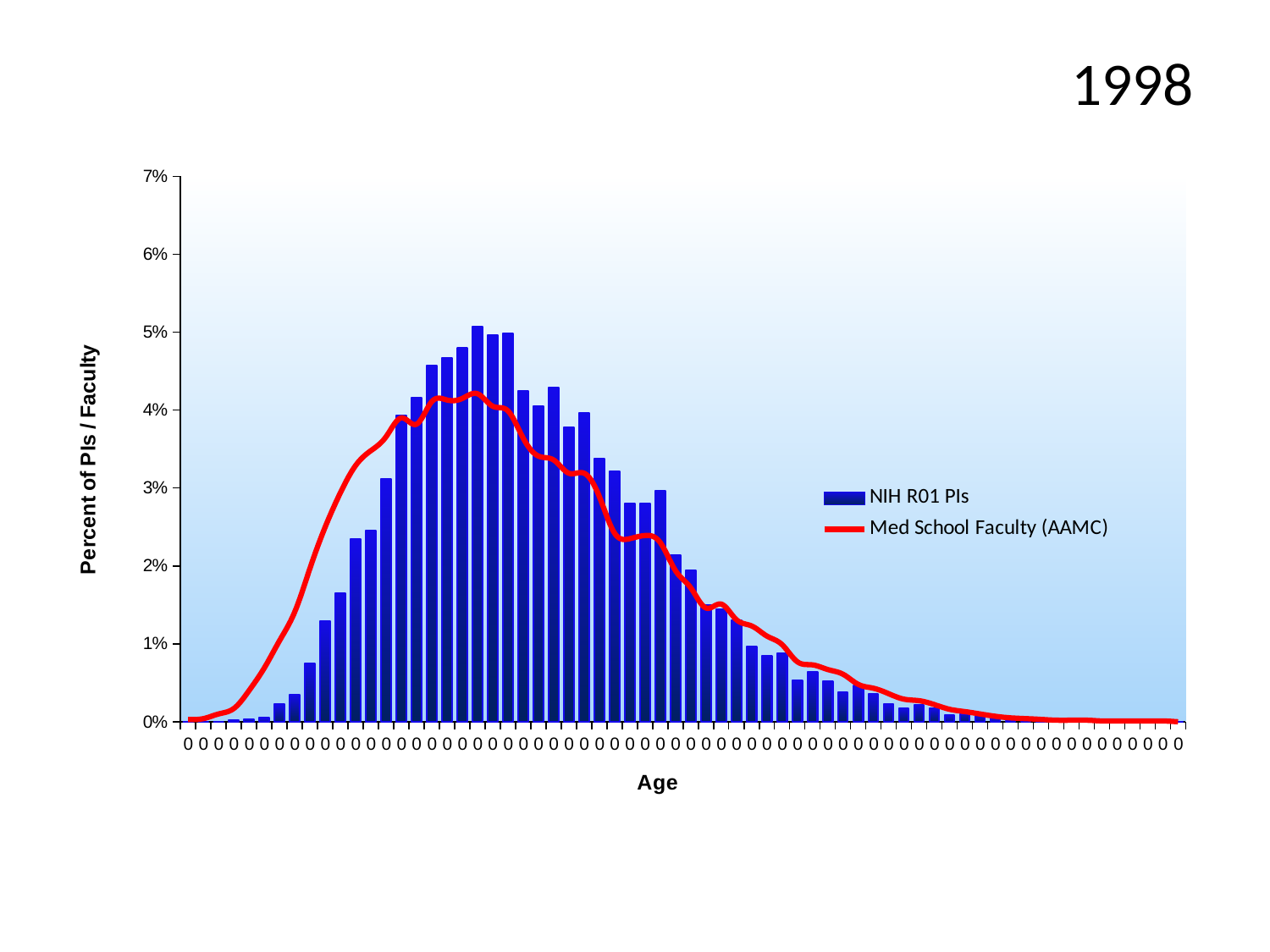
What is the label on the vertical axis? Percent of PIs / Faculty Which series reaches a higher peak value, NIH R01 PIs or Med School Faculty (AAMC)? NIH R01 PIs What kind of chart is shown on the slide? A bar chart combined with a line Is the tallest NIH R01 PIs bar greater or less than 4%? greater How many series does the legend list? 2 Is the highest point of the Med School Faculty (AAMC) line greater or less than 3%? greater Toward the right end of the Age axis, do the values of the Med School Faculty (AAMC) line rise or fall? fall Is the highest point of the Med School Faculty (AAMC) line greater or less than 5%? less Toward the right end of the Age axis, do the values of the NIH R01 PIs series rise or fall? fall What are the two series named in the legend? NIH R01 PIs and Med School Faculty (AAMC)